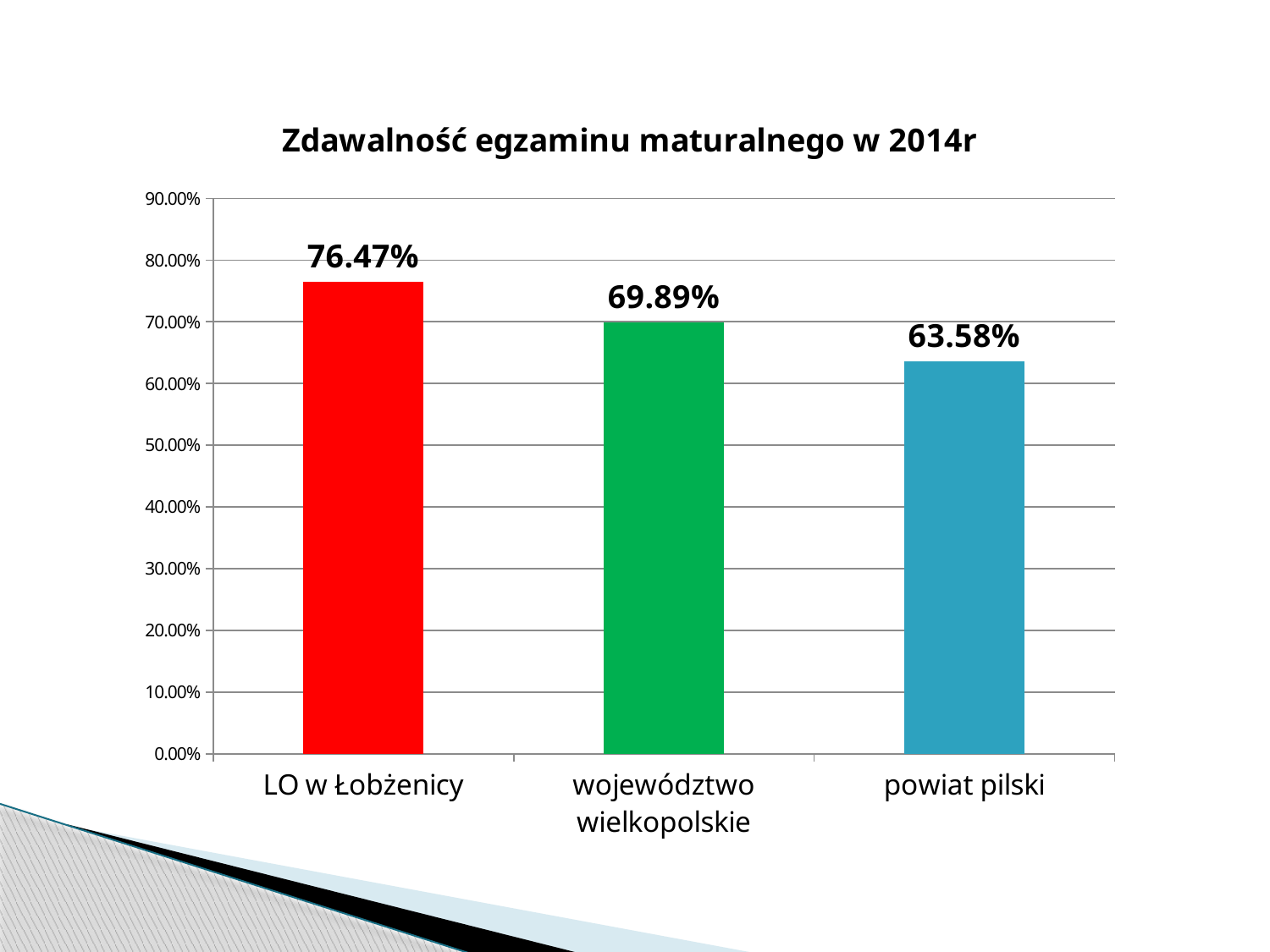
Is the value for powiat pilski greater or less than 70.00%? less How many categories are shown on the chart? 3 What is the title of the chart? Zdawalność egzaminu maturalnego w 2014r What kind of chart is shown on the slide? bar chart Which is larger, the value for LO w Łobżenicy or the value for województwo wielkopolskie? LO w Łobżenicy What is the difference between the values for LO w Łobżenicy and powiat pilski? 12.89% What is the value for LO w Łobżenicy? 76.47% What is the value for powiat pilski? 63.58% Which category has the lowest value? powiat pilski Which category has the highest value? LO w Łobżenicy What is the difference between the values for województwo wielkopolskie and powiat pilski? 6.31% What is the value for województwo wielkopolskie? 69.89%